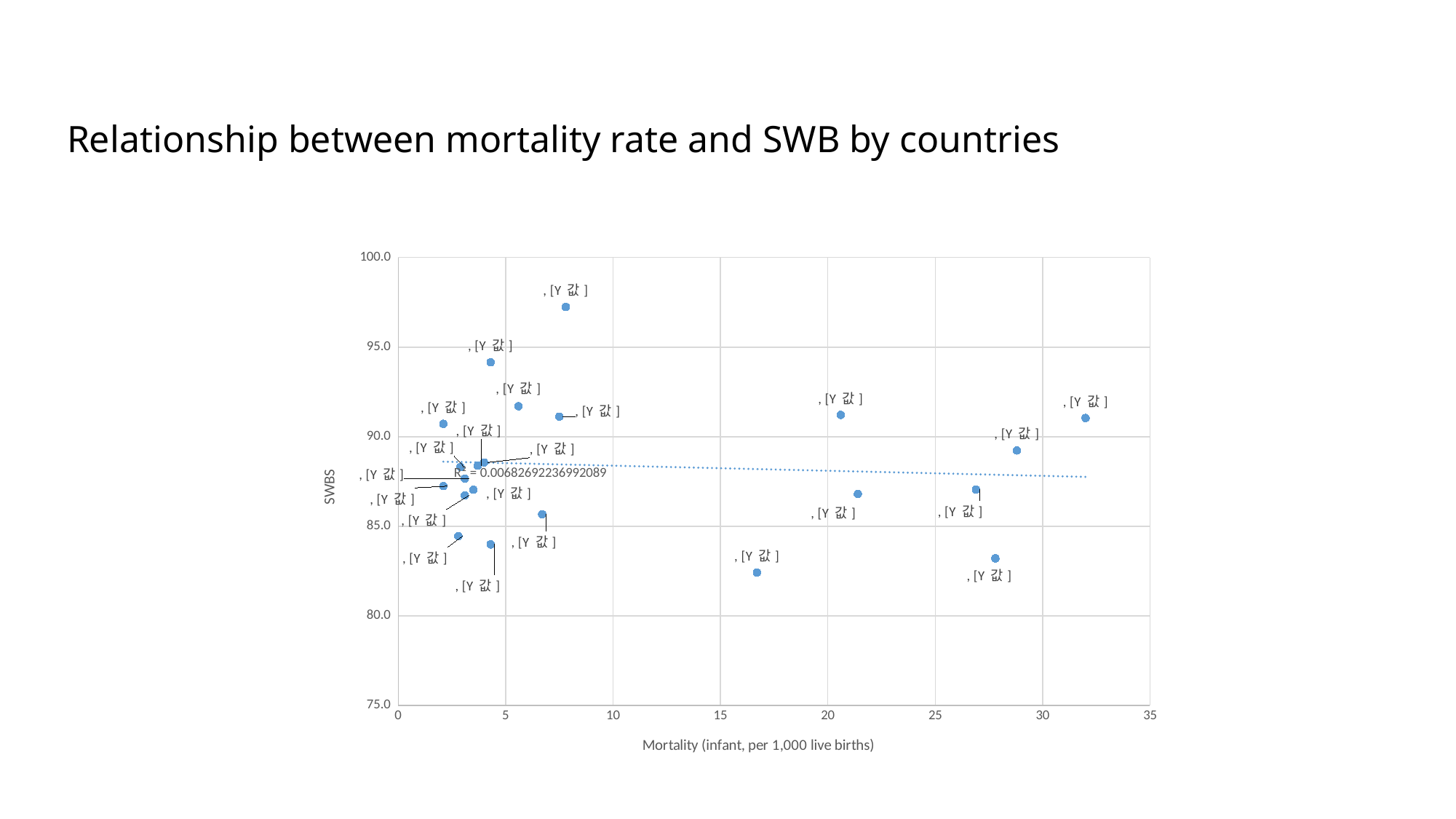
Is the mortality value of the point with the highest SWBS greater or less than 10? less What kind of chart is shown on the slide? Scatter chart What is the label of the horizontal axis of the chart? Mortality (infant, per 1,000 live births) What R² value is printed on the chart? R² = 0.00682692236992089 What is the title of the chart on the slide? Relationship between mortality rate and SWB by countries Is the SWBS value of the lowest point on the chart greater or less than 85? less What is the maximum value shown on the vertical (SWBS) axis? 100.0 Is the SWBS value of the rightmost point (highest mortality) greater or less than 90? greater Does the dotted trendline rise or fall as mortality increases along the x axis? Falls slightly